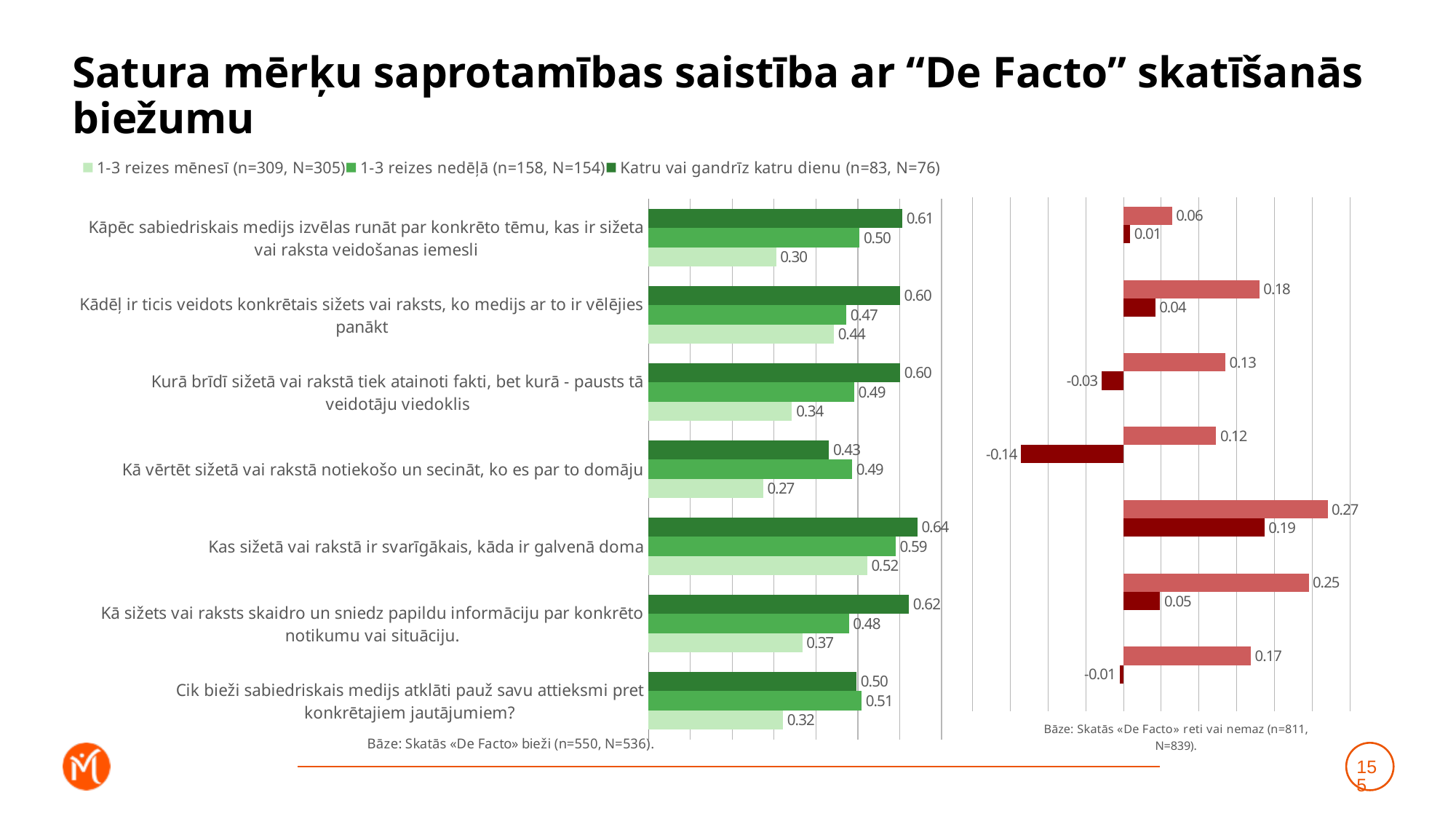
On the left chart, for "Kā vērtēt sižetā vai rakstā notiekošo un secināt, ko es par to domāju", which is larger: "Katru vai gandrīz katru dienu" or "1-3 reizes nedēļā"? 1-3 reizes nedēļā How many series does the legend of the left chart list? 3 On the left chart, what is the value for "Katru vai gandrīz katru dienu" for "Kas sižetā vai rakstā ir svarīgākais, kāda ir galvenā doma"? 0.64 On the right chart, what is the lowest value shown? -0.14 On the left chart, what is the value for "1-3 reizes mēnesī" for "Kā vērtēt sižetā vai rakstā notiekošo un secināt, ko es par to domāju"? 0.27 On the left chart, which category has the highest value for "1-3 reizes mēnesī"? Kas sižetā vai rakstā ir svarīgākais, kāda ir galvenā doma How many categories are shown on the left chart? 7 On the left chart, what is the value for "1-3 reizes nedēļā" for "Cik bieži sabiedriskais medijs atklāti pauž savu attieksmi pret konkrētajiem jautājumiem?"? 0.51 On the right chart, what is the value of the light red bar for "Kas sižetā vai rakstā ir svarīgākais, kāda ir galvenā doma"? 0.27 On the left chart, which category has the lowest value for "Katru vai gandrīz katru dienu"? Kā vērtēt sižetā vai rakstā notiekošo un secināt, ko es par to domāju On the left chart, what is the difference between the "Katru vai gandrīz katru dienu" and "1-3 reizes mēnesī" values for "Kāpēc sabiedriskais medijs izvēlas runāt par konkrēto tēmu, kas ir sižeta vai raksta veidošanas iemesli"? 0.31 What kind of chart is the left chart? Bar chart